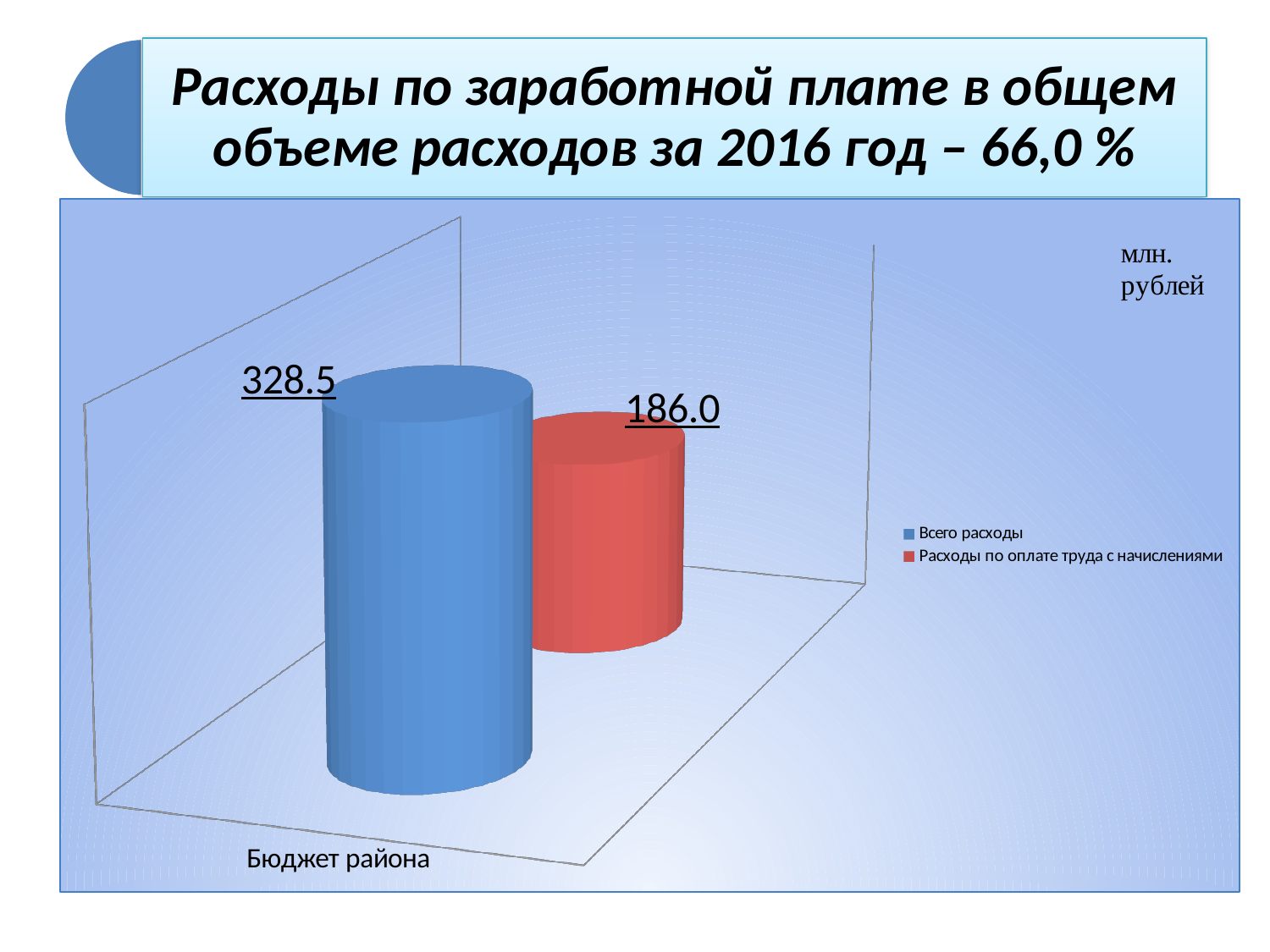
Which series has the lowest value in the chart? Расходы по оплате труда с начислениями What is the value for "Всего расходы" in the chart? 328.5 How many series does the legend list? 2 What unit is indicated in the top right corner of the chart? млн. рублей How many categories are shown on the x axis of the chart? 1 What is the name of the category shown on the x axis? Бюджет района What is the value for "Расходы по оплате труда с начислениями" in the chart? 186.0 Which series has the highest value in the chart? Всего расходы What kind of chart is shown on the slide? Bar chart What is the difference between the value for "Всего расходы" and the value for "Расходы по оплате труда с начислениями"? 142.5 Which series has the higher value, "Всего расходы" or "Расходы по оплате труда с начислениями"? Всего расходы